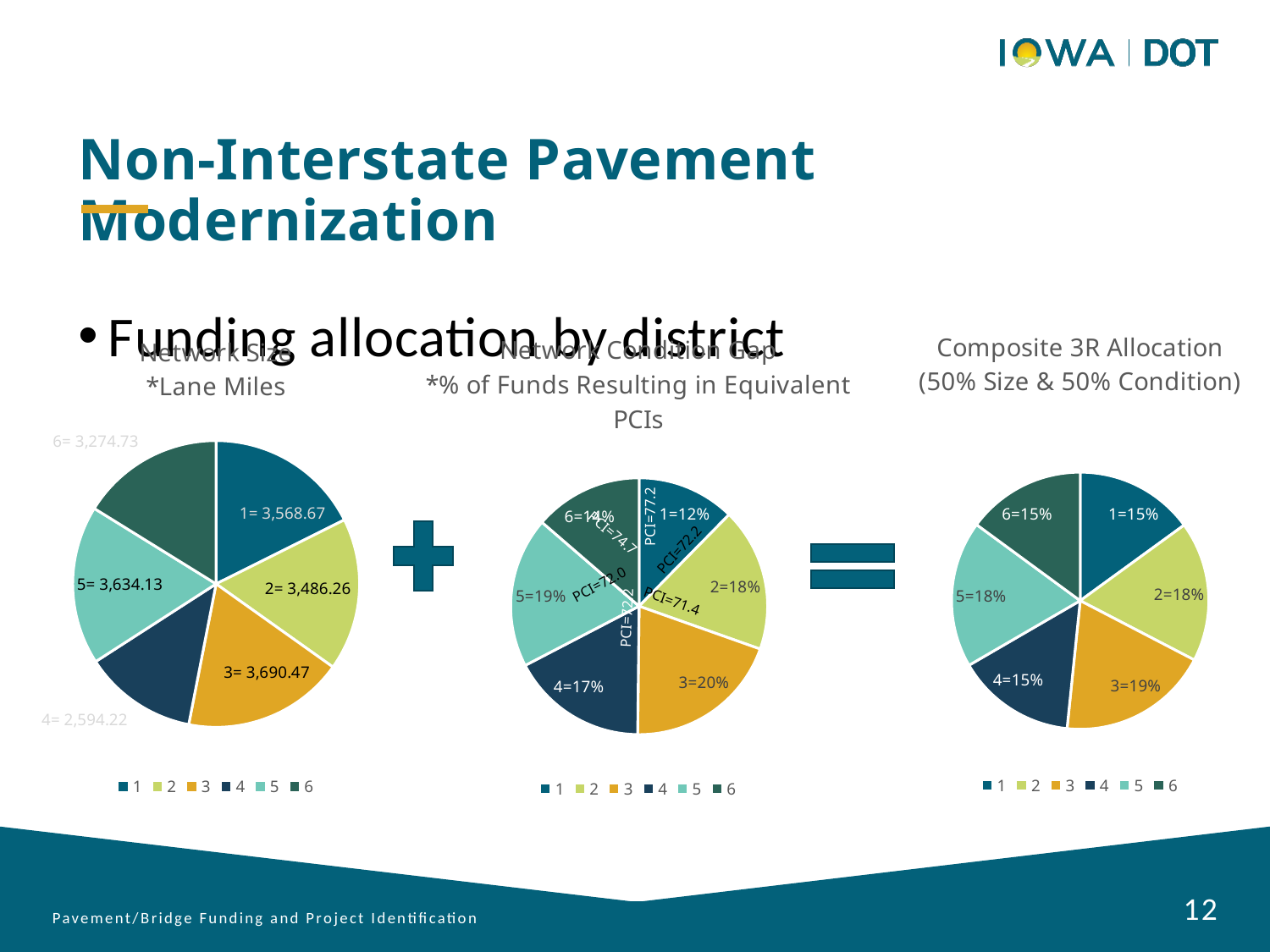
In the Composite 3R Allocation pie chart, which is larger, the value for district 2 or district 4? District 2 What type of chart is used for the Composite 3R Allocation? Pie chart In the Composite 3R Allocation pie chart, which district has the highest percentage? 3 In the left pie chart (Lane Miles), what is the difference between the values for district 1 and district 4? 974.45 How many slices does the Composite 3R Allocation pie chart have? 6 In the left pie chart (Lane Miles), which district has the smallest value? 4 In the middle pie chart, which district has the lowest percentage? 1 In the middle pie chart, what is the difference between the percentages for district 3 and district 1? 8 percentage points In the middle pie chart, what percentage is shown for district 3? 20% In the left pie chart (Lane Miles), what is the value for district 3? 3,690.47 In the left pie chart (Lane Miles), which district has the largest value? 3 In the Composite 3R Allocation pie chart, what percentage is shown for district 2? 18%